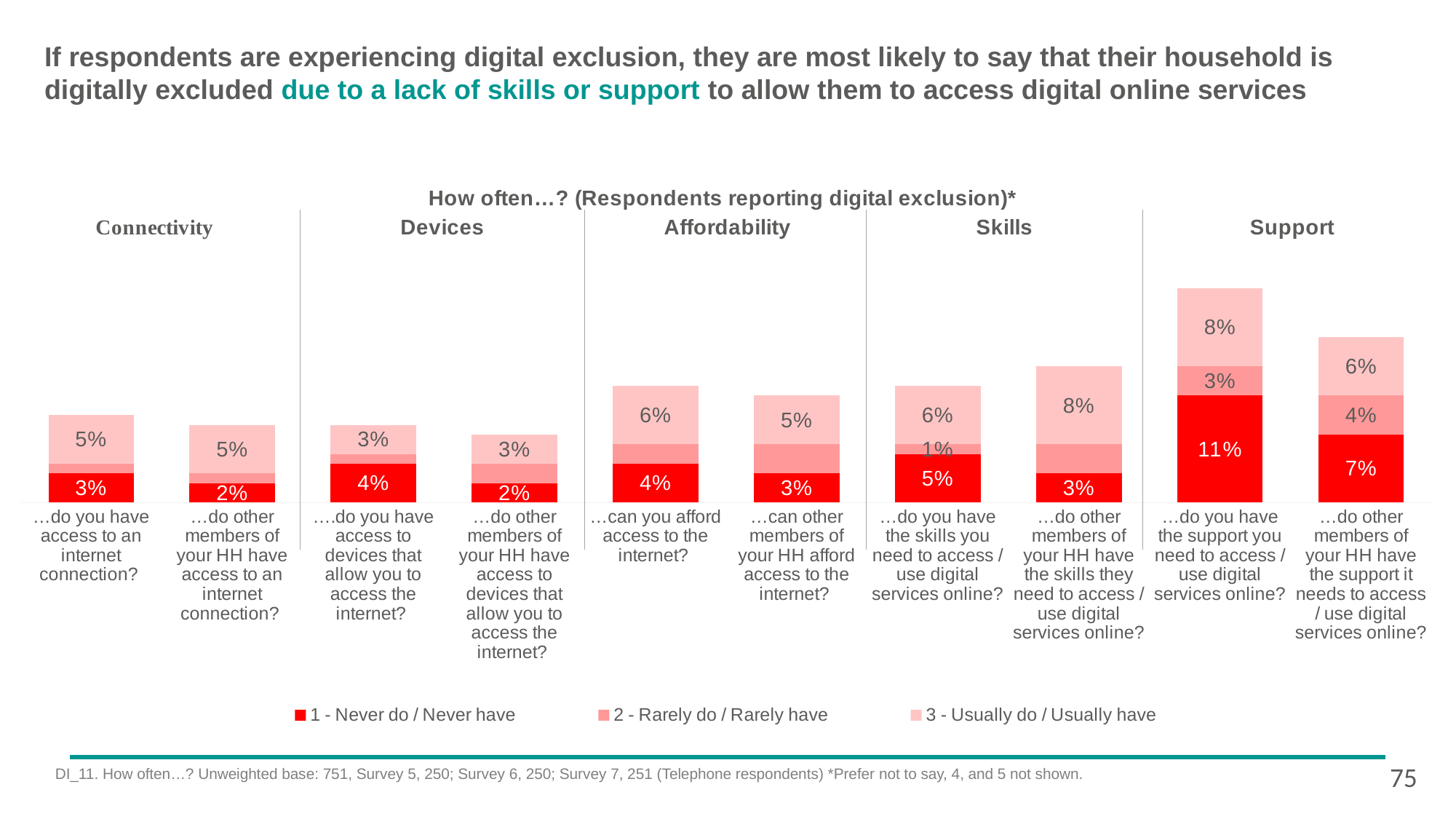
What is the title of the chart? How often…? (Respondents reporting digital exclusion)* What is the '1 - Never do / Never have' value for '…can you afford access to the internet?' 4% Which question has the highest '1 - Never do / Never have' value? …do you have the support you need to access / use digital services online? How many series does the legend list? 3 What kind of chart is shown on the slide? Stacked bar chart How many bars (questions) are plotted in the chart? 10 What is the '1 - Never do / Never have' value for '…do you have the support you need to access / use digital services online?' 11% What is the '2 - Rarely do / Rarely have' value for '…do other members of your HH have the support it needs to access / use digital services online?' 4% What is the total of the stacked bar for '…do you have the support you need to access / use digital services online?' 22% What is the '3 - Usually do / Usually have' value for '…do other members of your HH have the skills they need to access / use digital services online?' 8% What is the difference between the '1 - Never do / Never have' values for '…do you have the support you need to access / use digital services online?' and '…do other members of your HH have the support it needs to access / use digital services online?' 4 percentage points Which has the larger '1 - Never do / Never have' value: '…do you have the skills you need to access / use digital services online?' or '…do you have the support you need to access / use digital services online?' …do you have the support you need to access / use digital services online?